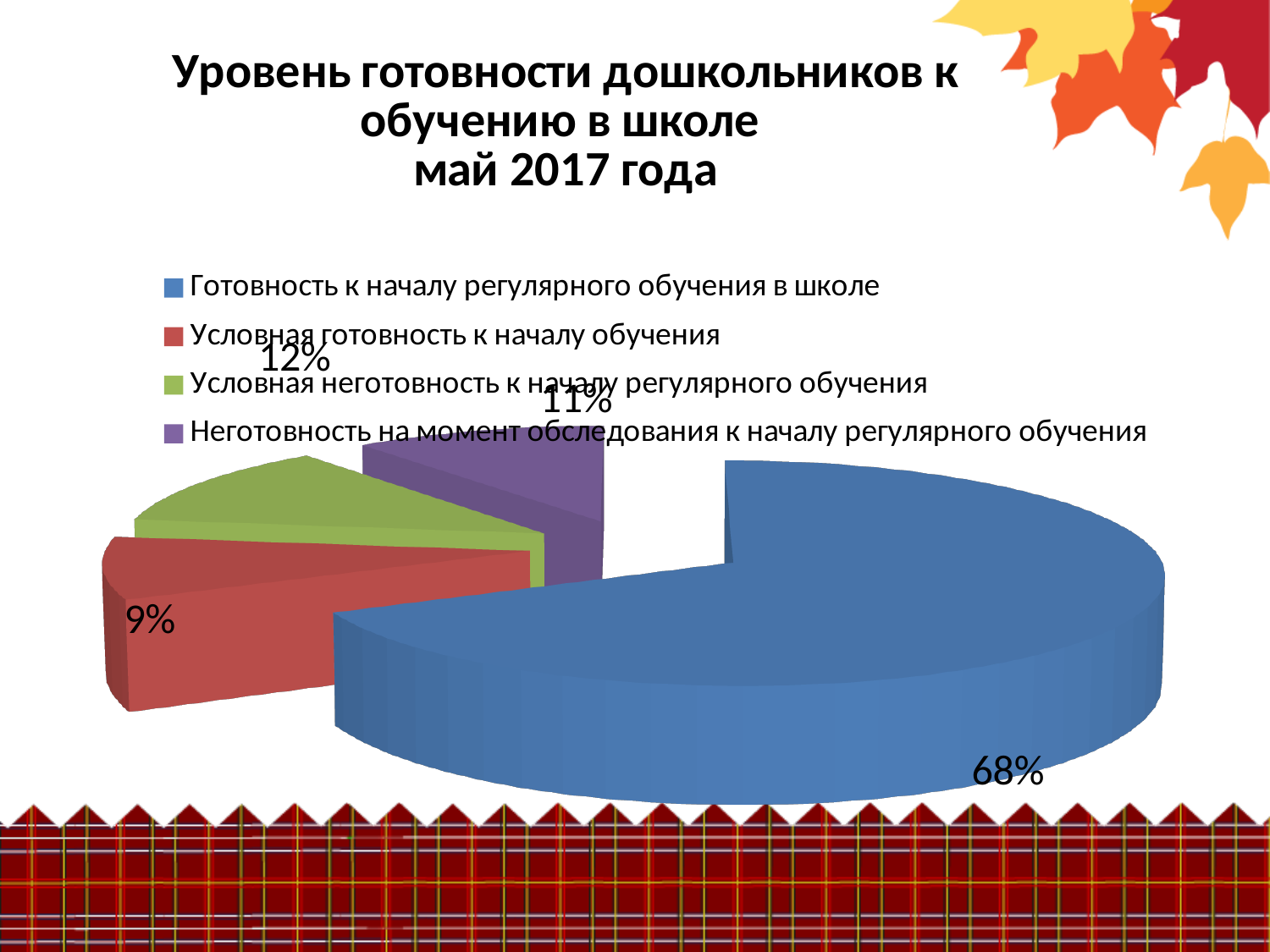
What colour is the slice for "Готовность к началу регулярного обучения в школе"? blue What percentage is shown for "Неготовность на момент обследования к началу регулярного обучения"? 11% What is the title of the chart on the slide? Уровень готовности дошкольников к обучению в школе май 2017 года What is the difference in percentage points between "Готовность к началу регулярного обучения в школе" and "Условная неготовность к началу регулярного обучения"? 56 What percentage is shown for "Условная готовность к началу обучения"? 9% Which category has the largest share of the pie? Готовность к началу регулярного обучения в школе Which category has the smallest share of the pie? Условная готовность к началу обучения What percentage is shown for "Условная неготовность к началу регулярного обучения"? 12% How many slices does the pie chart have? 4 Which is larger: the share for "Условная неготовность к началу регулярного обучения" or the share for "Условная готовность к началу обучения"? Условная неготовность к началу регулярного обучения What percentage is shown for "Готовность к началу регулярного обучения в школе"? 68% What kind of chart is shown on the slide? pie chart